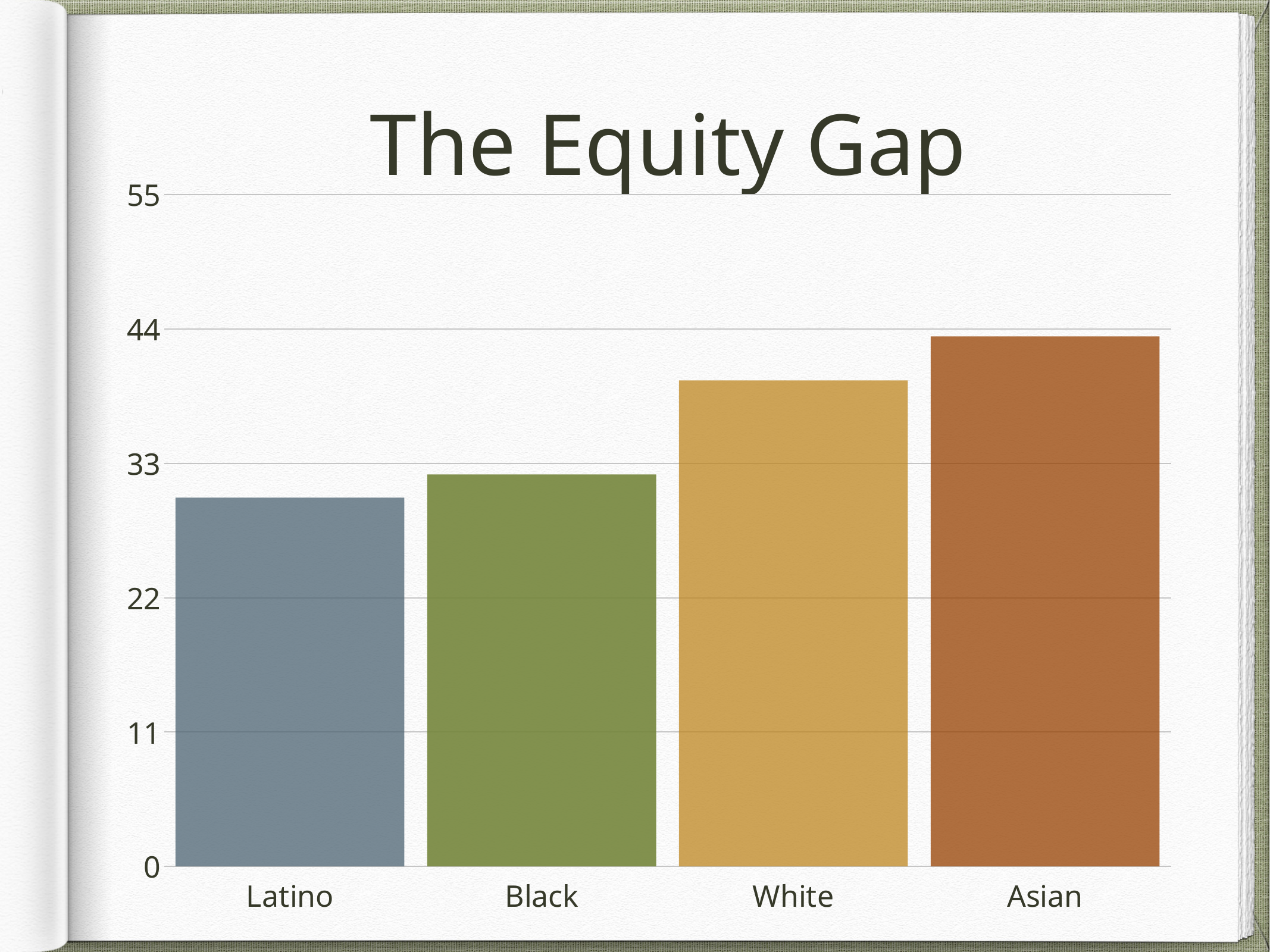
What kind of chart is shown on the slide? bar chart How many categories are shown on the x axis? 4 Which category has the highest bar? Asian Is the value for Latino greater or less than 33? less Which is larger, the value for White or the value for Black? White Which is larger, the value for Asian or the value for Latino? Asian What is the title of the chart? The Equity Gap Is the value for White greater or less than 33? greater Is the value for White greater or less than 44? less Do the bar values rise or fall moving from Latino to Asian along the x axis? rise Which category has the lowest bar? Latino